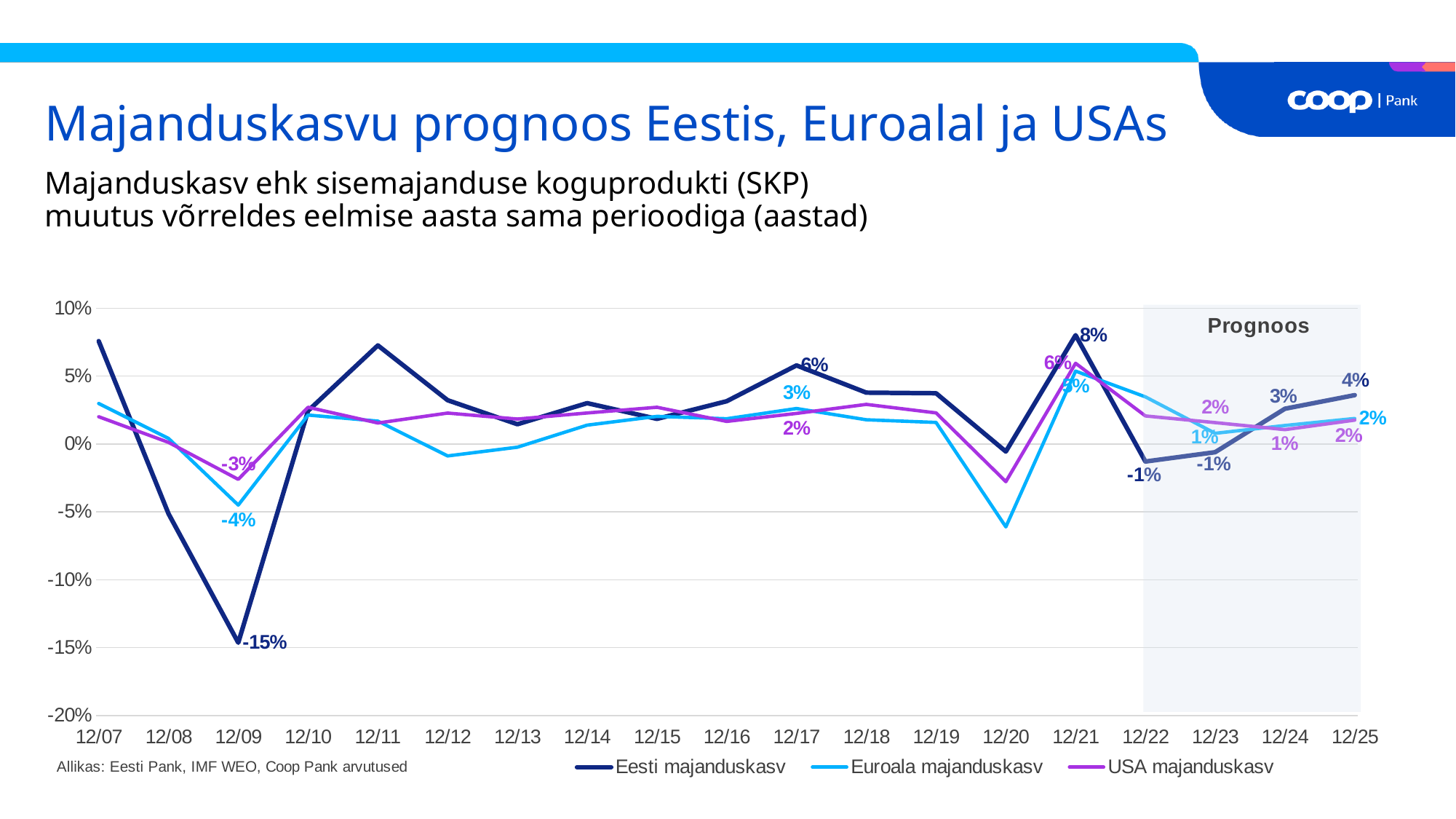
What is the difference between Eesti majanduskasv and Euroala majanduskasv at 12/21? 3 percentage points At which date does Eesti majanduskasv reach its lowest value? 12/09 Is the value of Euroala majanduskasv at 12/20 greater or less than -5%? less What is the value of Eesti majanduskasv at 12/21? 8% How many series does the legend list? 3 What is the value of Eesti majanduskasv at 12/09? -15% What is the forecast value of USA majanduskasv at 12/25? 2% At 12/17, which is larger: Eesti majanduskasv or Euroala majanduskasv? Eesti majanduskasv What is the value of Euroala majanduskasv at 12/09? -4% Is the value of Eesti majanduskasv at 12/07 greater or less than 5%? greater How many dates are shown on the x axis? 19 What kind of chart is shown on the slide? line chart